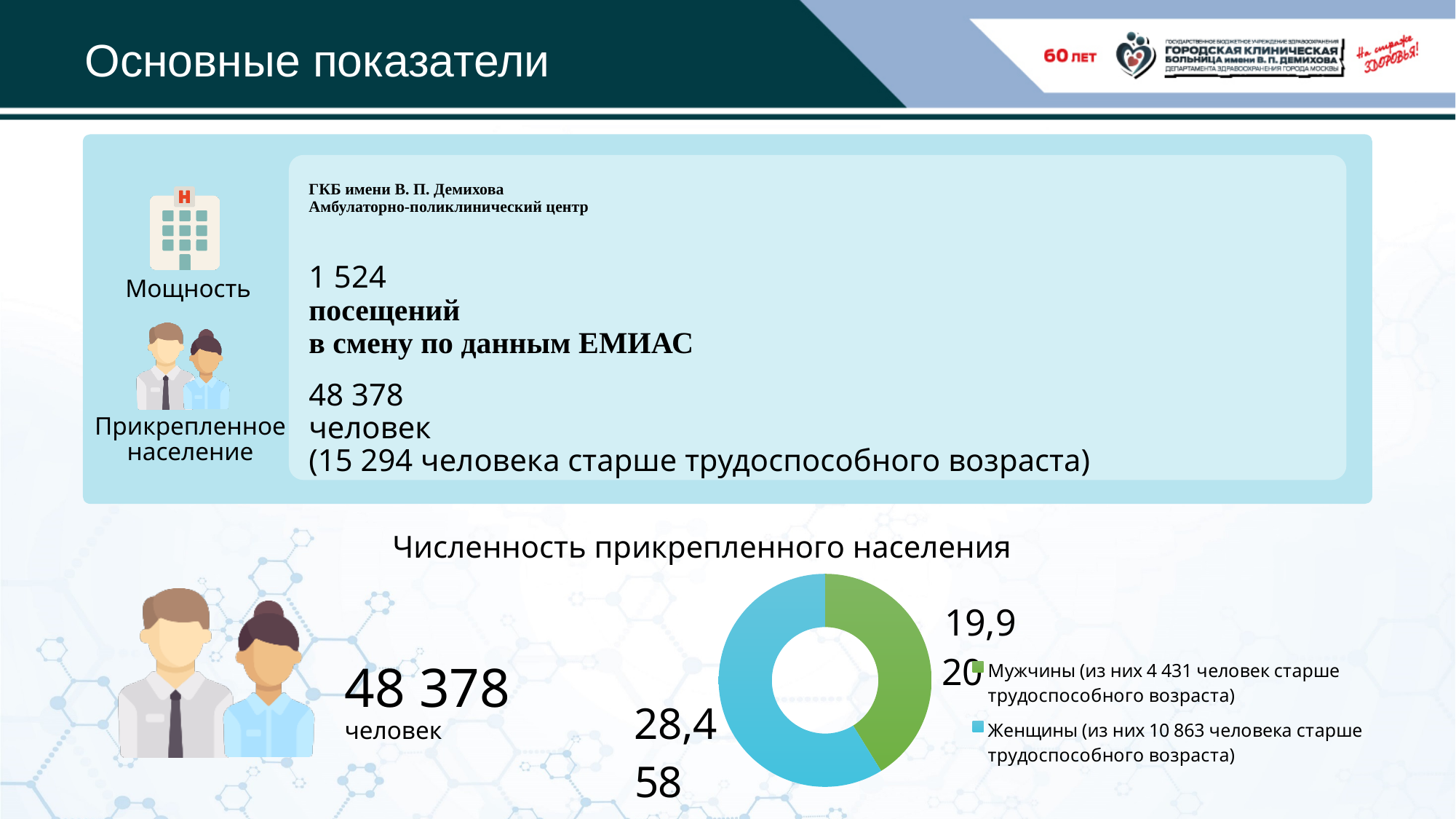
What kind of chart is shown under the title "Численность прикрепленного населения"? Donut (pie) chart What is the title of the donut chart on the slide? Численность прикрепленного населения How many entries does the legend of the donut chart list? 2 Which category has the smallest slice in the donut chart "Численность прикрепленного населения"? Мужчины Which category has the largest slice in the donut chart "Численность прикрепленного населения"? Женщины Which colour represents Мужчины in the donut chart? Green Which slice of the donut chart is larger, Мужчины or Женщины? Женщины How many slices does the donut chart "Численность прикрепленного населения" have? 2 Is the Женщины slice of the donut chart more or less than half of the whole? More